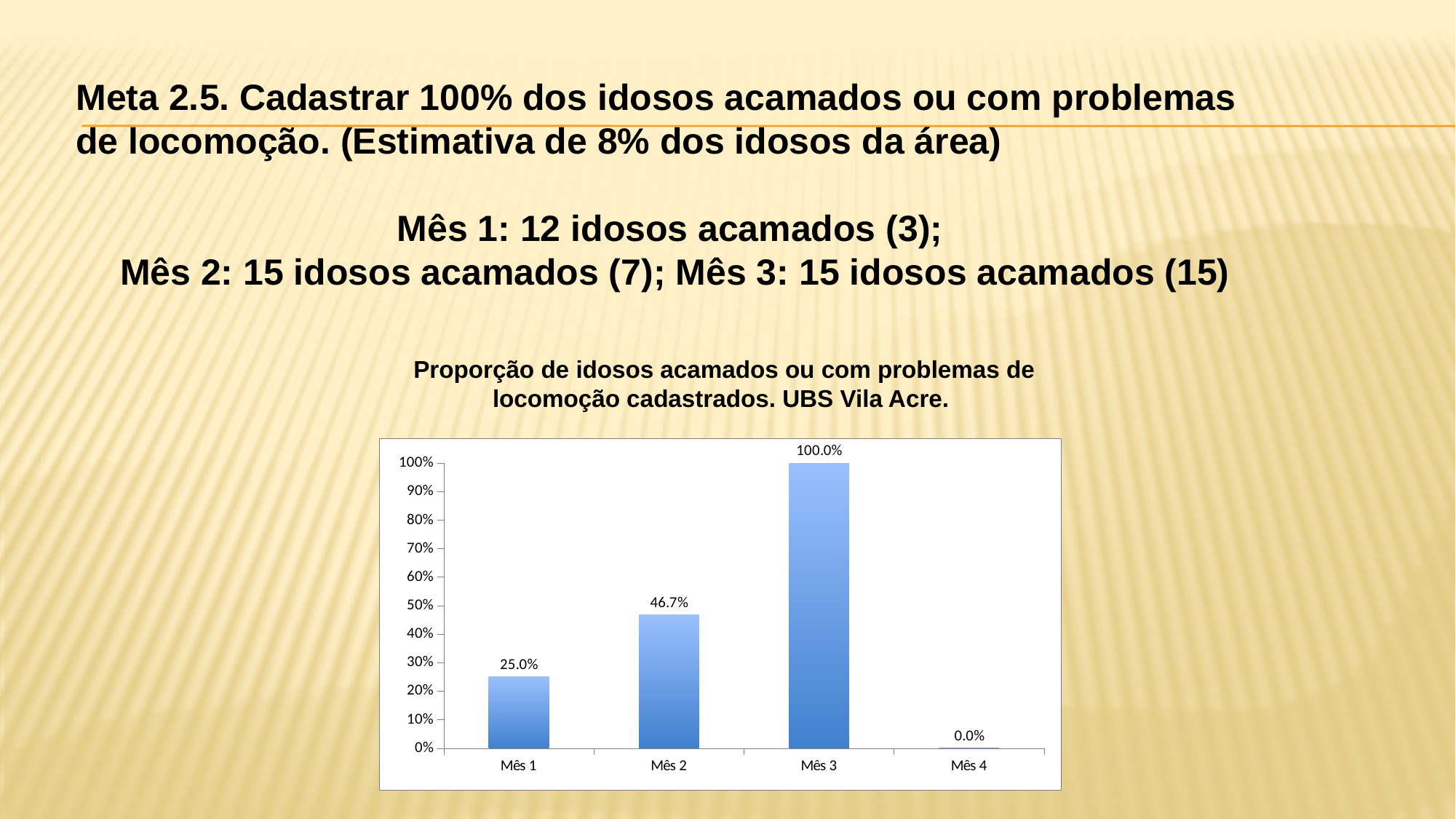
What is the value for Mês 2? 46.7% What is the value for Mês 4? 0.0% What kind of chart is shown? bar chart What is the title of the chart? Proporção de idosos acamados ou com problemas de locomoção cadastrados. UBS Vila Acre. Which is larger, the value for Mês 1 or the value for Mês 2? Mês 2 What is the difference between the values for Mês 3 and Mês 2? 53.3% What is the value for Mês 3? 100.0% What is the value for Mês 1? 25.0% How many months are shown on the x axis? 4 Is the value for Mês 2 greater or less than 40%? greater Which month has the highest value? Mês 3 Which month has the lowest value? Mês 4